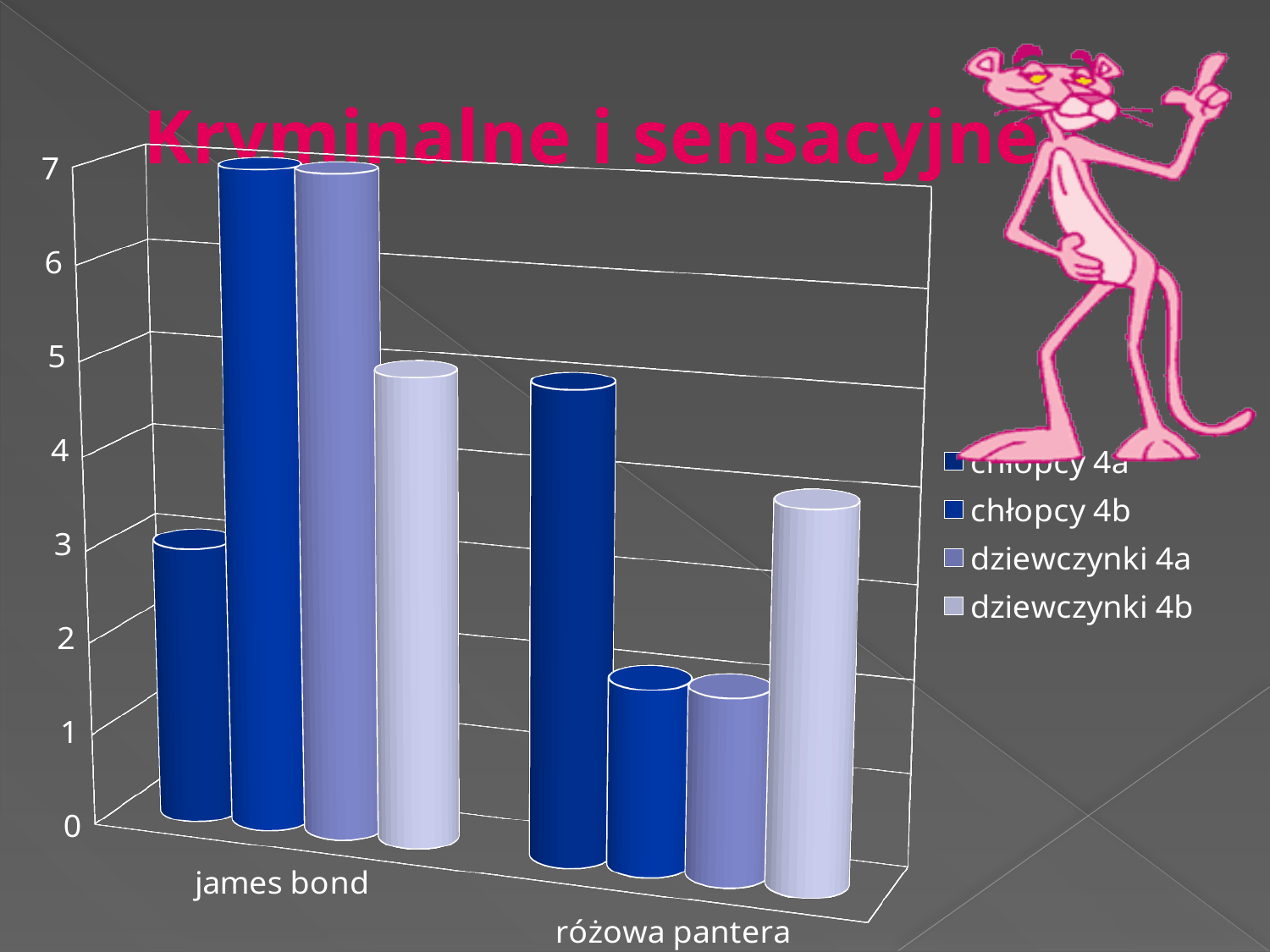
Which series has the lowest value in the james bond category? chłopcy 4a Is the value for chłopcy 4b in the różowa pantera category greater or less than 3? less How many categories are shown on the x axis? 2 Is the value for chłopcy 4b in the james bond category greater or less than 6? greater What kind of chart is shown on the slide? bar chart Is the value for chłopcy 4a in the różowa pantera category greater or less than 3? greater Which series has the highest value in the różowa pantera category? chłopcy 4a How many series does the legend list? 4 What is the title of the chart? Kryminalne i sensacyjne Which series is shown in the lightest colour in the legend? dziewczynki 4b For dziewczynki 4b, which category has the larger value: james bond or różowa pantera? james bond